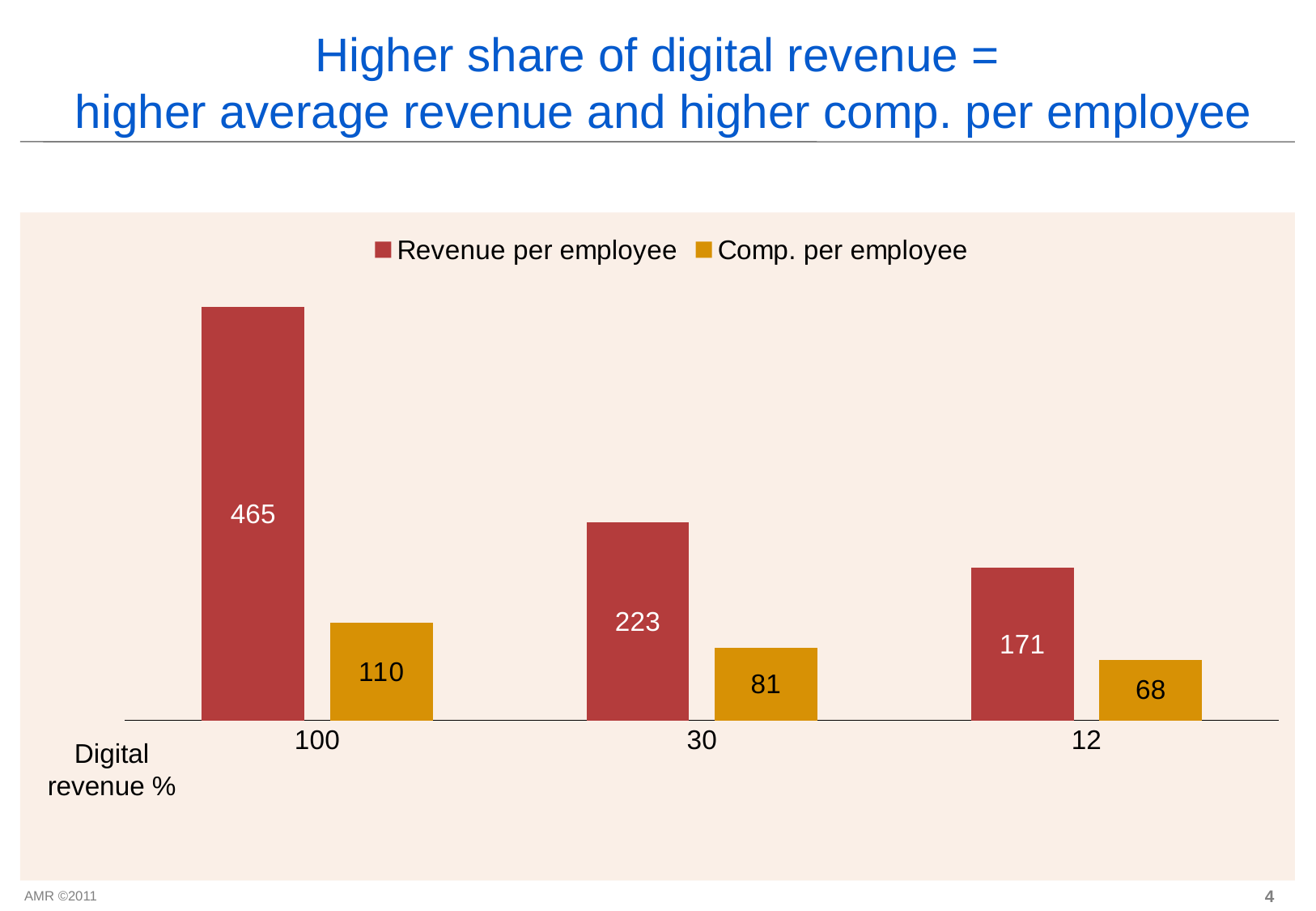
What is the difference between Comp. per employee at 100 digital revenue % and at 12 digital revenue %? 42 How many digital revenue % categories are shown on the x axis? 3 Which digital revenue % category has the highest Revenue per employee? 100 What is the Comp. per employee value for the 12 digital revenue % category? 68 Do the Revenue per employee values rise or fall moving from left to right along the x axis? Fall What is the Comp. per employee value for the 30 digital revenue % category? 81 Which digital revenue % category has the lowest Comp. per employee? 12 Which is larger: Revenue per employee at 30 digital revenue % or Revenue per employee at 12 digital revenue %? Revenue per employee at 30 digital revenue % How many series does the legend list? 2 What kind of chart is shown on the slide? Bar chart What is the difference between Revenue per employee at 100 digital revenue % and at 30 digital revenue %? 242 What is the Revenue per employee value for the 100 digital revenue % category? 465